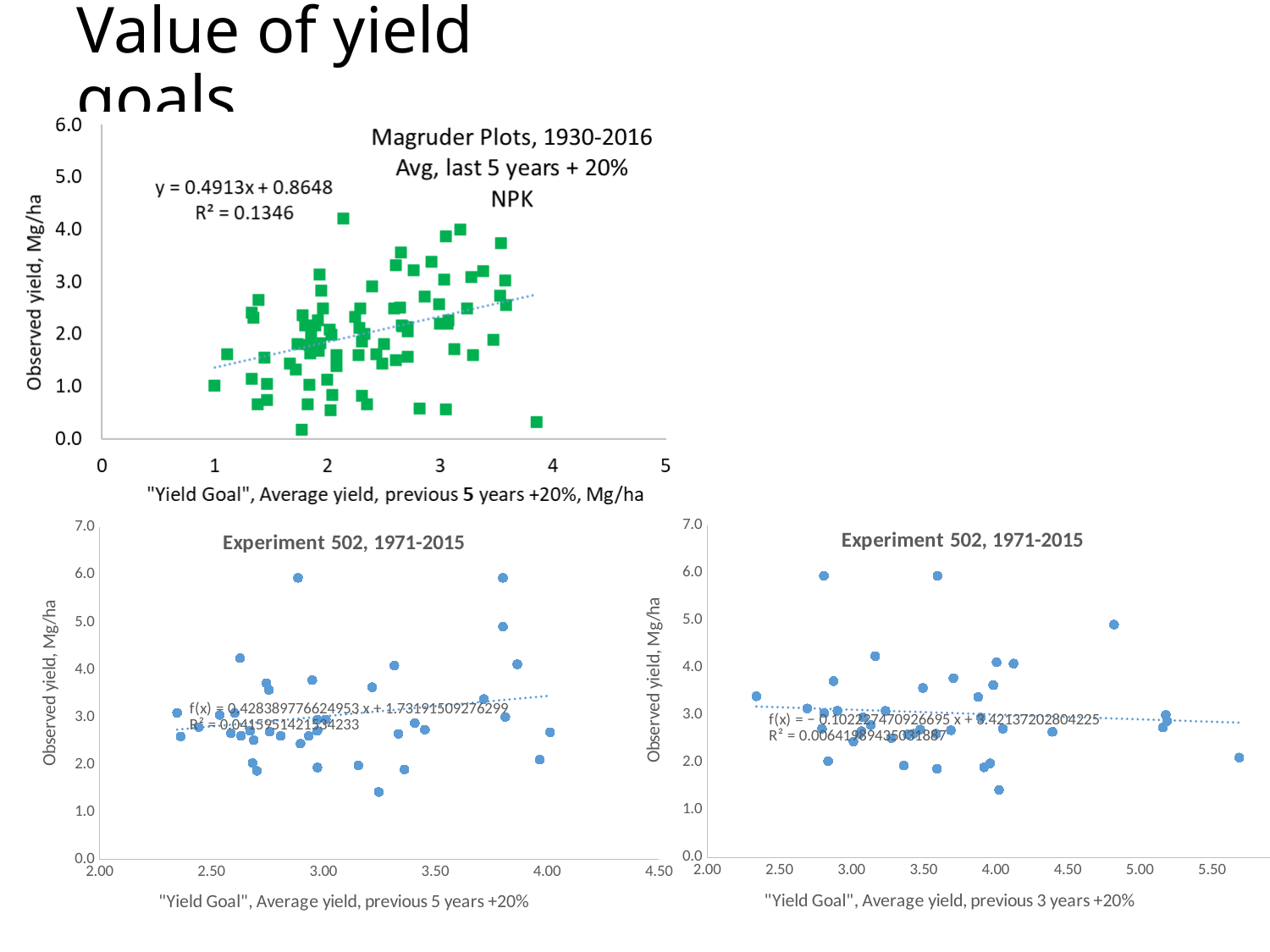
What kind of chart is the top chart titled 'Magruder Plots, 1930-2016'? scatter chart What is the intercept in the trendline equation of the bottom-right chart (Experiment 502, previous 3 years)? 3.42137202804225 What is the y-axis title of the top chart (Magruder Plots, 1930-2016)? Observed yield, Mg/ha In the bottom-right chart (Experiment 502, 1971-2015, previous 3 years), what is the R² value shown? R² = 0.00641989435031887 Which chart has the higher R² value, the top Magruder Plots chart or the bottom-left Experiment 502 chart? the top Magruder Plots chart What is the x-axis title of the bottom-right chart? "Yield Goal", Average yield, previous 3 years +20% In the top chart (Magruder Plots, 1930-2016), does the trendline rise or fall as the yield goal increases? rise In the top chart (Magruder Plots, 1930-2016), what is the R² value shown? R² = 0.1346 In the bottom-left chart (Experiment 502, 1971-2015, previous 5 years), what is the R² value shown? R² = 0.0415951421534233 In the bottom-right chart (Experiment 502, 1971-2015, previous 3 years), does the trendline rise or fall as the yield goal increases? fall What is the slope coefficient in the trendline equation of the bottom-left chart (Experiment 502, previous 5 years)? 0.428389776624953 In the top chart (Magruder Plots, 1930-2016), what is the trendline equation shown? y = 0.4913x + 0.8648